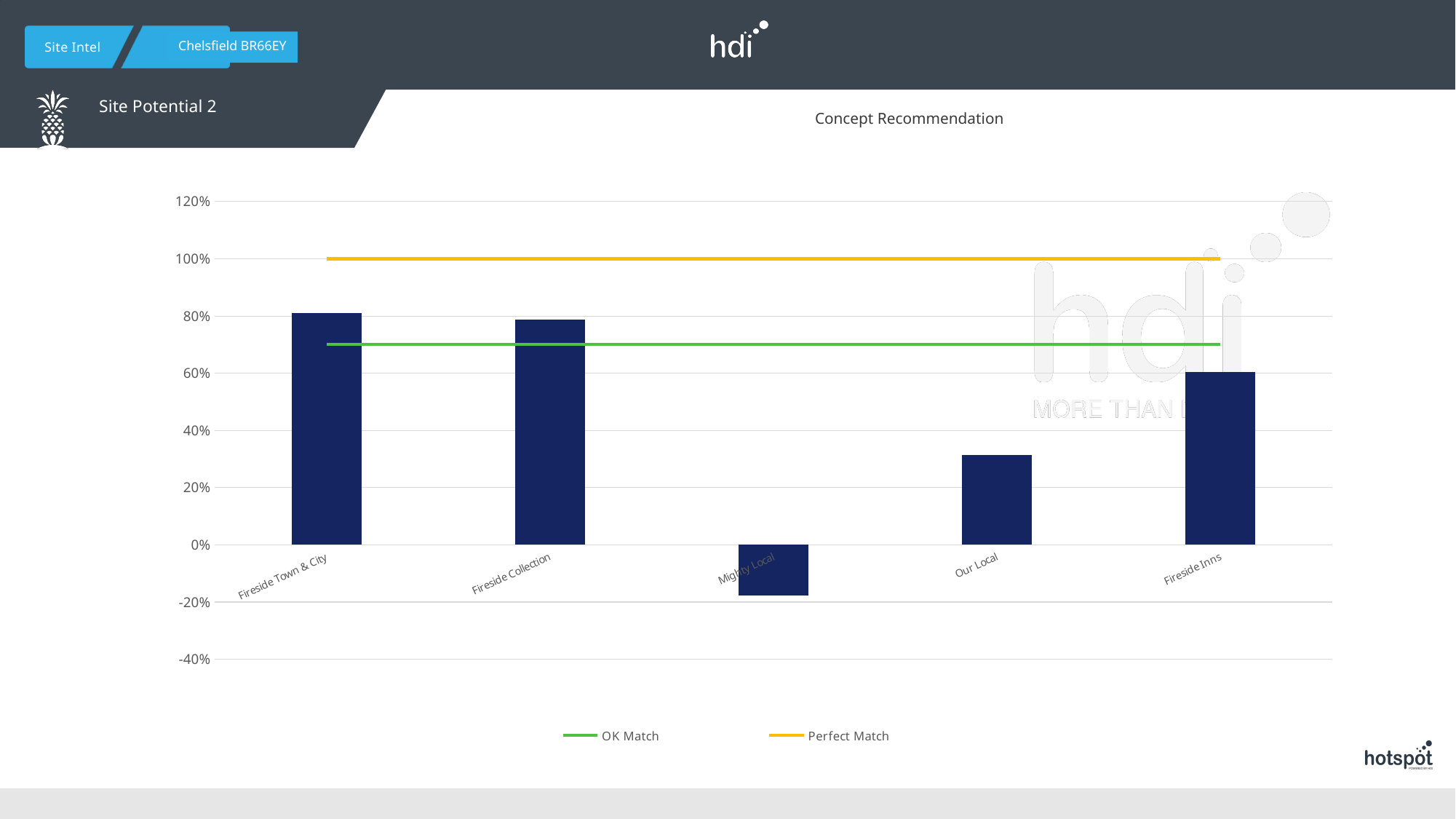
How many series does the legend list? 2 Which is larger, the value for Our Local or the value for Fireside Inns? Fireside Inns Is the value for Fireside Town & City greater or less than 60%? greater At what level on the y axis is the Perfect Match line drawn? 100% Which is larger, the value for Fireside Collection or the value for Our Local? Fireside Collection What is the title of the chart? Concept Recommendation Is the value for Fireside Inns greater or less than 80%? less Which category has the lowest value? Mighty Local How many concept categories are plotted on the x axis? 5 What kind of chart is shown on the slide? bar chart Is the value for Mighty Local greater or less than 0%? less